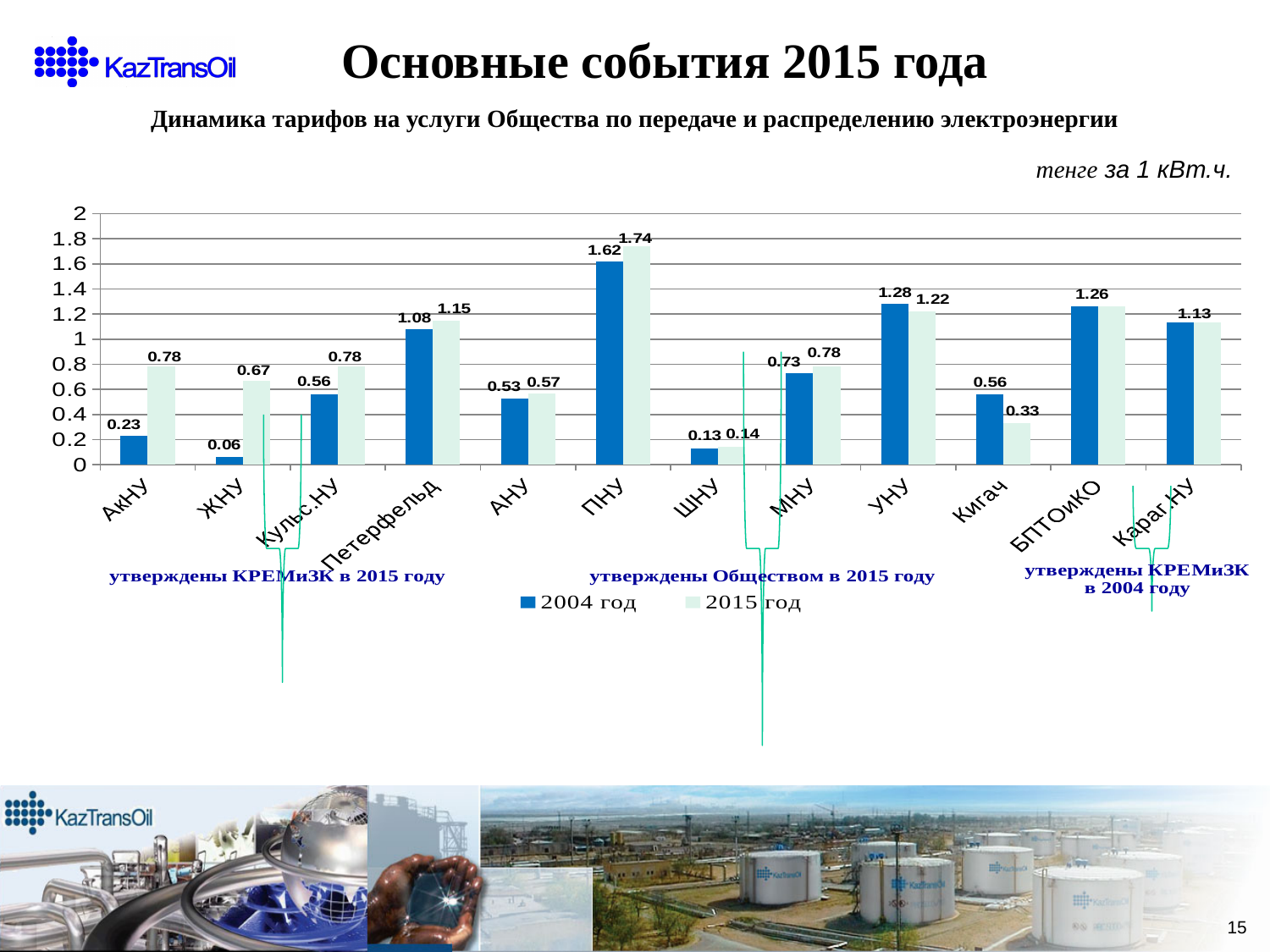
What is the 2004 год value for Кигач? 0.56 What is the 2015 год value for ПНУ? 1.74 What is the 2015 год value for АкНУ? 0.78 How many categories are shown on the x axis? 12 What kind of chart is shown on the slide? Bar chart What is the 2004 год value for ЖНУ? 0.06 Which category has the highest 2004 год value? ПНУ Which category has the lowest 2015 год value? ШНУ What unit is stated above the chart? тенге за 1 кВт.ч. Which is larger for УНУ: the 2004 год value or the 2015 год value? 2004 год What is the difference between the 2015 год and 2004 год values for АкНУ? 0.55 How many series does the legend list? 2